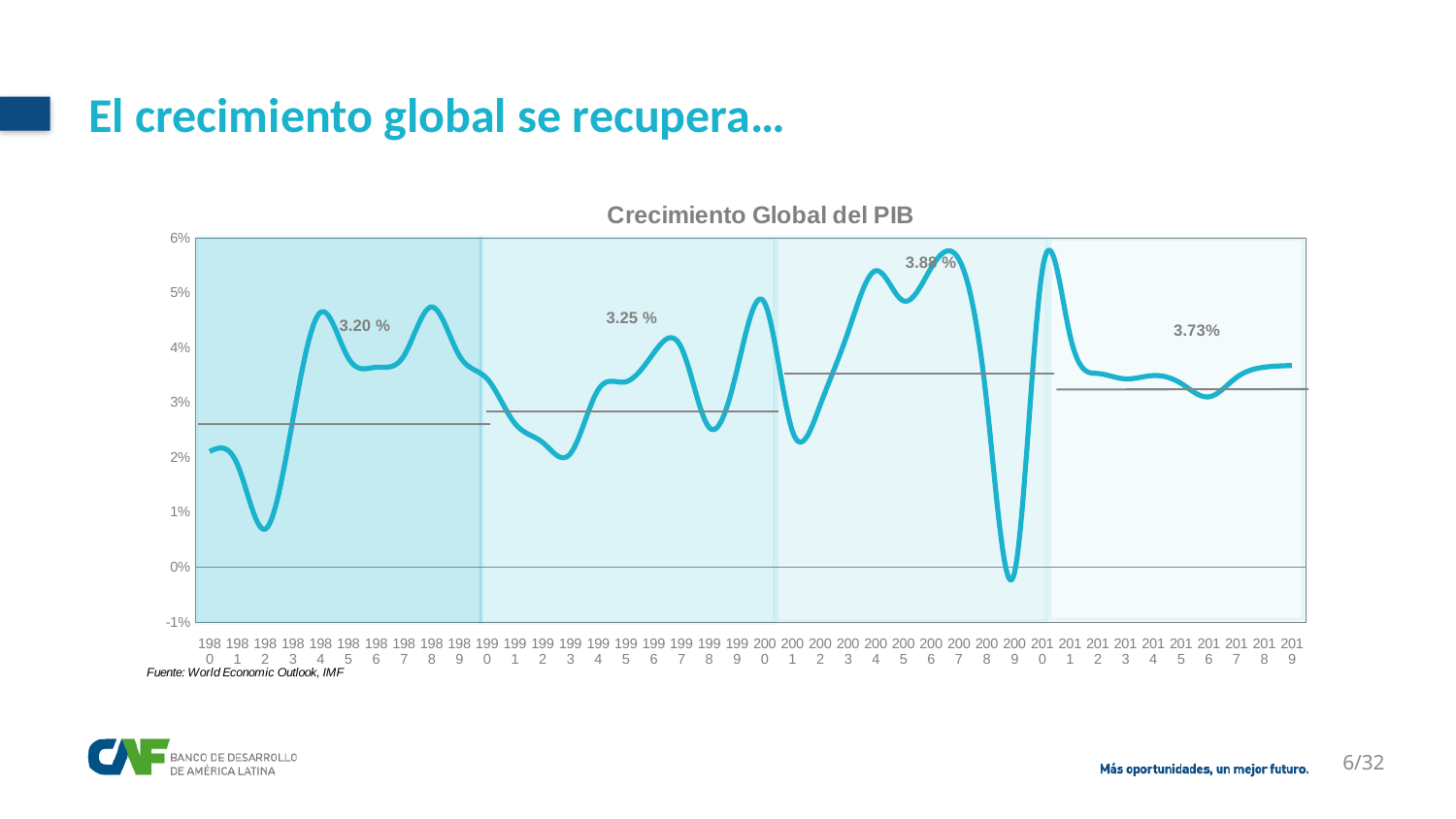
Is the value for 2007 greater or less than 5%? greater What is the difference between the labelled 2010s average (3.73%) and the 1980s average (3.20 %)? 0.53 percentage points Which labelled period average is larger, the 1980s (3.20 %) or the 1990s (3.25 %)? 1990s (3.25 %) What is the title of the chart? Crecimiento Global del PIB What kind of chart is shown on the slide? line chart What average growth value is labelled for the 1990s shaded period? 3.25 % What average growth value is labelled for the 2010s shaded period? 3.73% Does the line rise or fall between 1980 and 1982? fall In which year does the global GDP growth line reach its lowest point? 2009 What average growth value is labelled for the 1980s shaded period? 3.20 % Is the value for 1982 greater or less than 1%? less How many shaded period regions are marked on the chart? 4